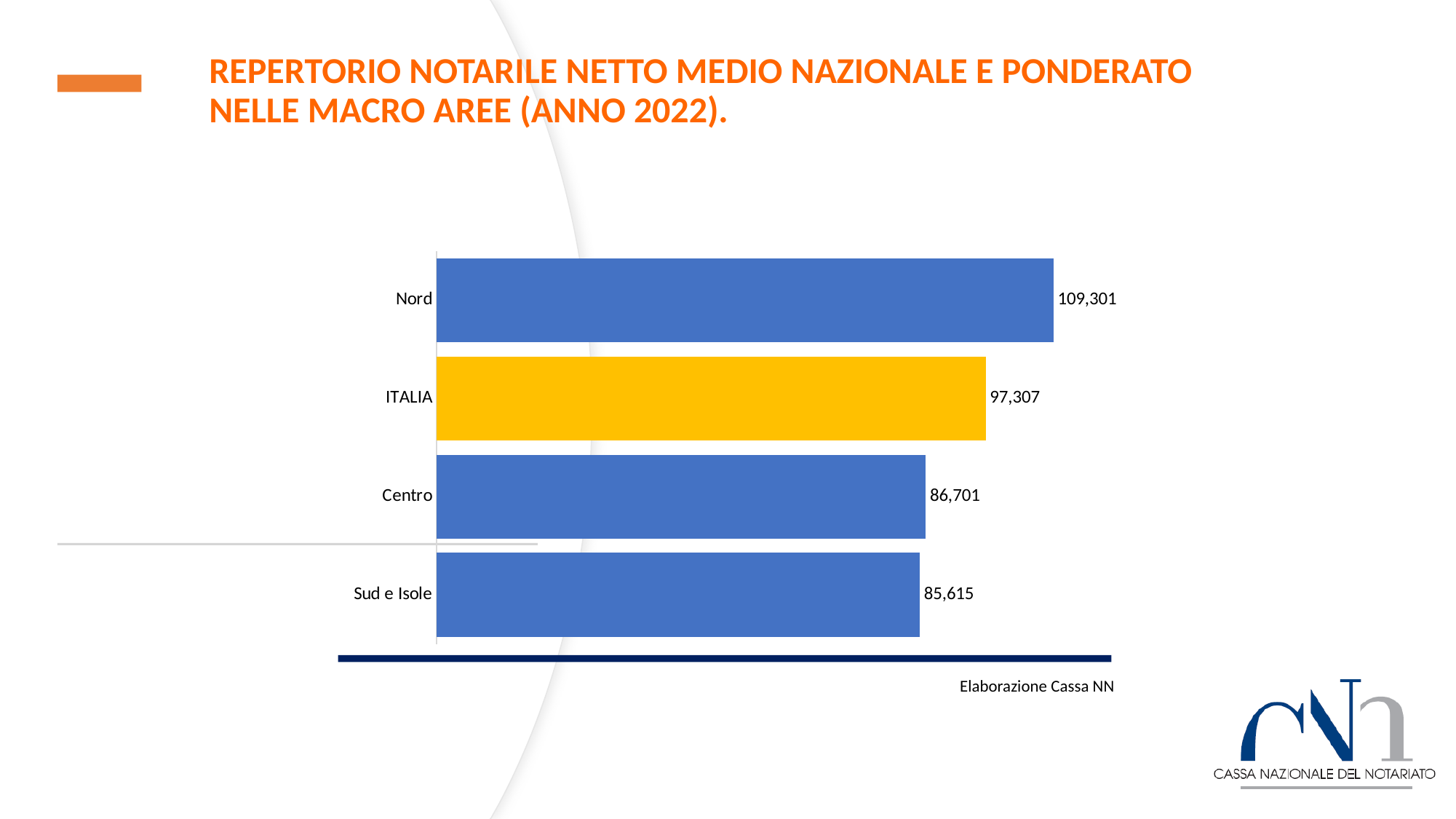
How many categories are shown in the chart? 4 What kind of chart is shown on the slide? Bar chart Which category's bar is coloured yellow rather than blue? ITALIA What is the value for Sud e Isole? 85,615 What is the difference between the values for Centro and Sud e Isole? 1,086 What is the value for Centro? 86,701 Which is larger, the value for Nord or the value for Centro? Nord What is the value for ITALIA? 97,307 What is the difference between the values for Nord and ITALIA? 11,994 Which category has the highest value? Nord What is the value for Nord? 109,301 Which category has the lowest value? Sud e Isole